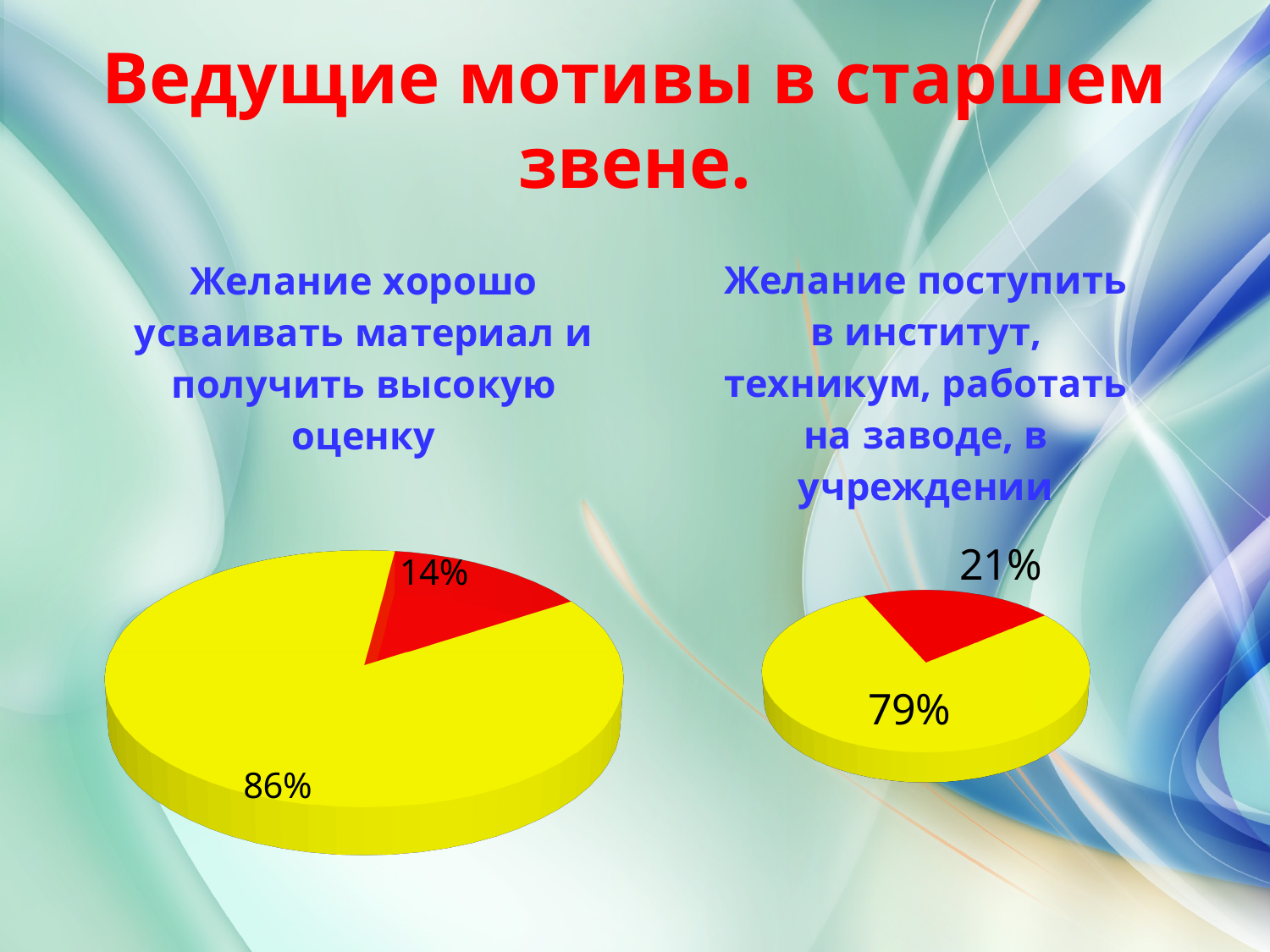
In the left pie chart, what percentage does the red slice represent? 14% What type of chart is shown on the right side of the slide? pie chart In the right pie chart, what percentage does the red slice represent? 21% In the left pie chart, which slice is larger, the yellow one or the red one? yellow In the right pie chart, which slice is the smallest? the red slice (21%) In the left pie chart, what percentage does the yellow slice represent? 86% Which is larger: the red slice of the left pie chart or the red slice of the right pie chart? the red slice of the right pie chart (21%) What is the difference between the yellow and red slices in the left pie chart? 72% How many slices does the right pie chart have? 2 How many slices does the left pie chart have? 2 What type of chart is shown on the left side of the slide? pie chart In the right pie chart, what percentage does the yellow slice represent? 79%